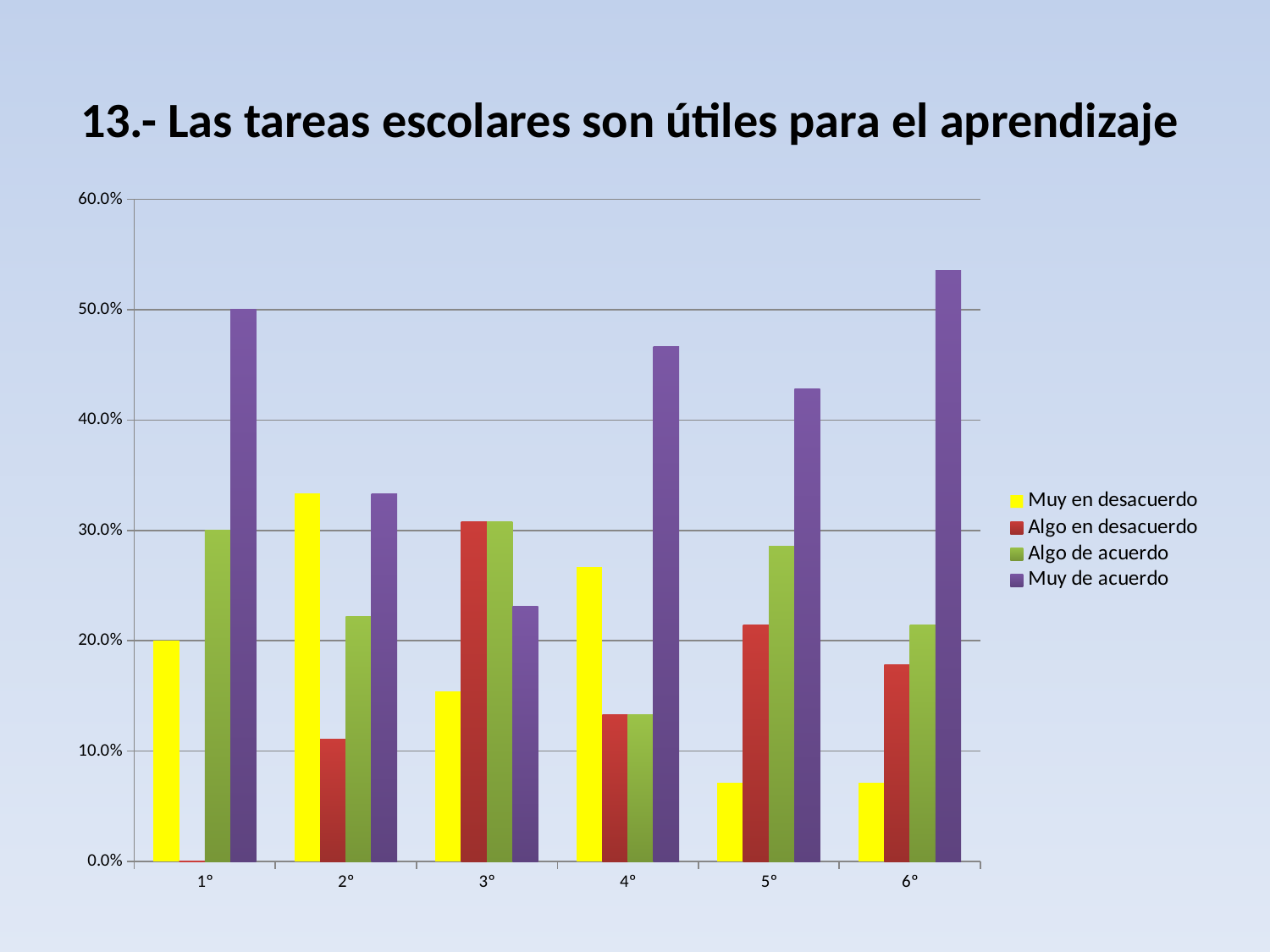
Is the value for 'Muy de acuerdo' in 4° greater or less than 40.0%? greater What is the value of 'Muy de acuerdo' for 1°? 50.0% Which colour represents 'Muy de acuerdo' in the legend? purple How many grade categories are shown on the x axis? 6 Which grade has the lowest 'Algo en desacuerdo' value? 1° Which grade has the highest 'Muy de acuerdo' value? 6° What is the value of 'Muy en desacuerdo' for 1°? 20.0% How many series does the legend list? 4 What kind of chart is shown on the slide? bar chart Which is larger for 3°: 'Algo en desacuerdo' or 'Muy de acuerdo'? Algo en desacuerdo Is the value for 'Muy en desacuerdo' in 5° greater or less than 10.0%? less Which is larger for 2°: 'Muy en desacuerdo' or 'Algo en desacuerdo'? Muy en desacuerdo